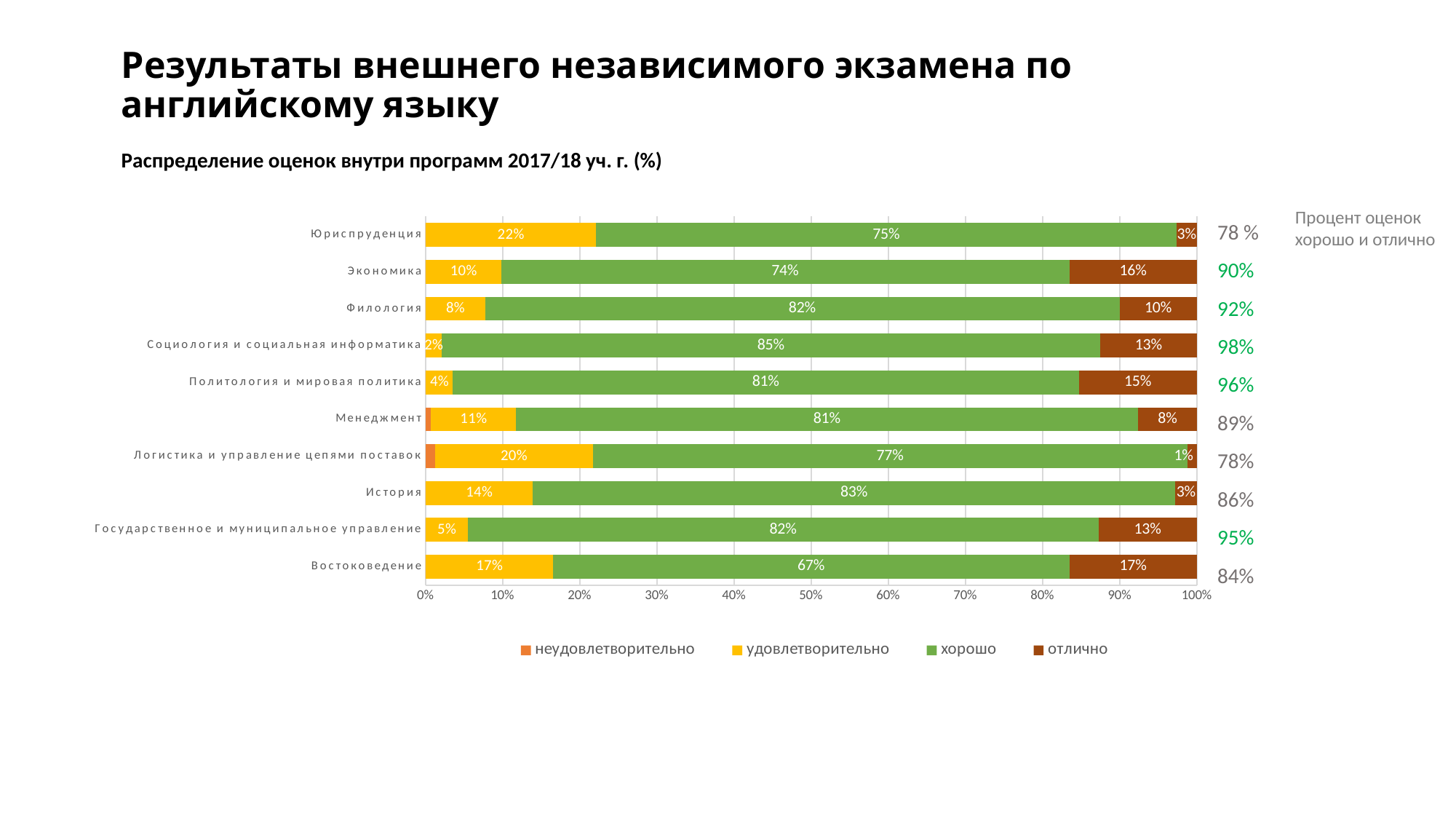
What is the combined share of хорошо and отлично grades for Политология и мировая политика? 96% What is the удовлетворительно value for Юриспруденция? 22% Which program has the highest share of отлично grades? Востоковедение What percentage of grades for Экономика are отлично? 16% What is the difference in percentage points between the отлично share for Востоковедение and for Менеджмент? 9 Which has a larger удовлетворительно share: Логистика и управление цепями поставок or История? Логистика и управление цепями поставок How many series does the legend list? 4 Which program has the lowest share of хорошо grades? Востоковедение How many programs are shown in the chart? 10 What kind of chart is shown on the slide? Stacked bar chart What is the value of the хорошо series for Филология? 82% Which program has the highest share of хорошо grades? Социология и социальная информатика